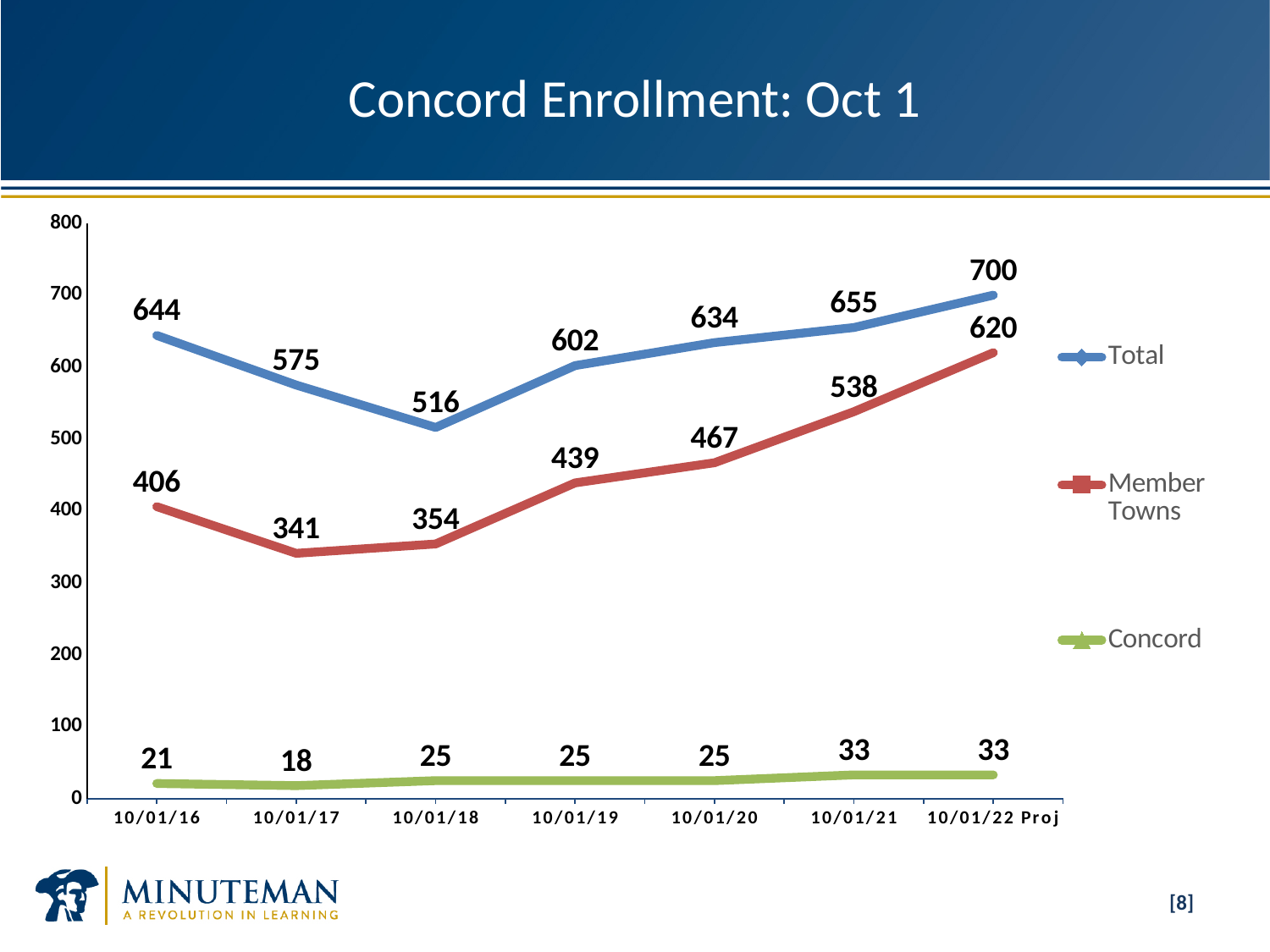
What is the Member Towns value on 10/01/20? 467 What is the Total enrollment value on 10/01/18? 516 What is the title of the chart? Concord Enrollment: Oct 1 On which date is the Total series at its lowest? 10/01/18 How many series does the legend list? 3 Which is larger: the Total value on 10/01/17 or the Total value on 10/01/19? 10/01/19 What kind of chart is shown on the slide? Line chart What is the Concord value on 10/01/17? 18 On which date is the Member Towns series at its highest? 10/01/22 Proj How many dates are shown on the x axis? 7 Does the Member Towns series rise or fall from 10/01/18 to 10/01/22 Proj? Rise What is the difference between the Total and Member Towns values on 10/01/16? 238